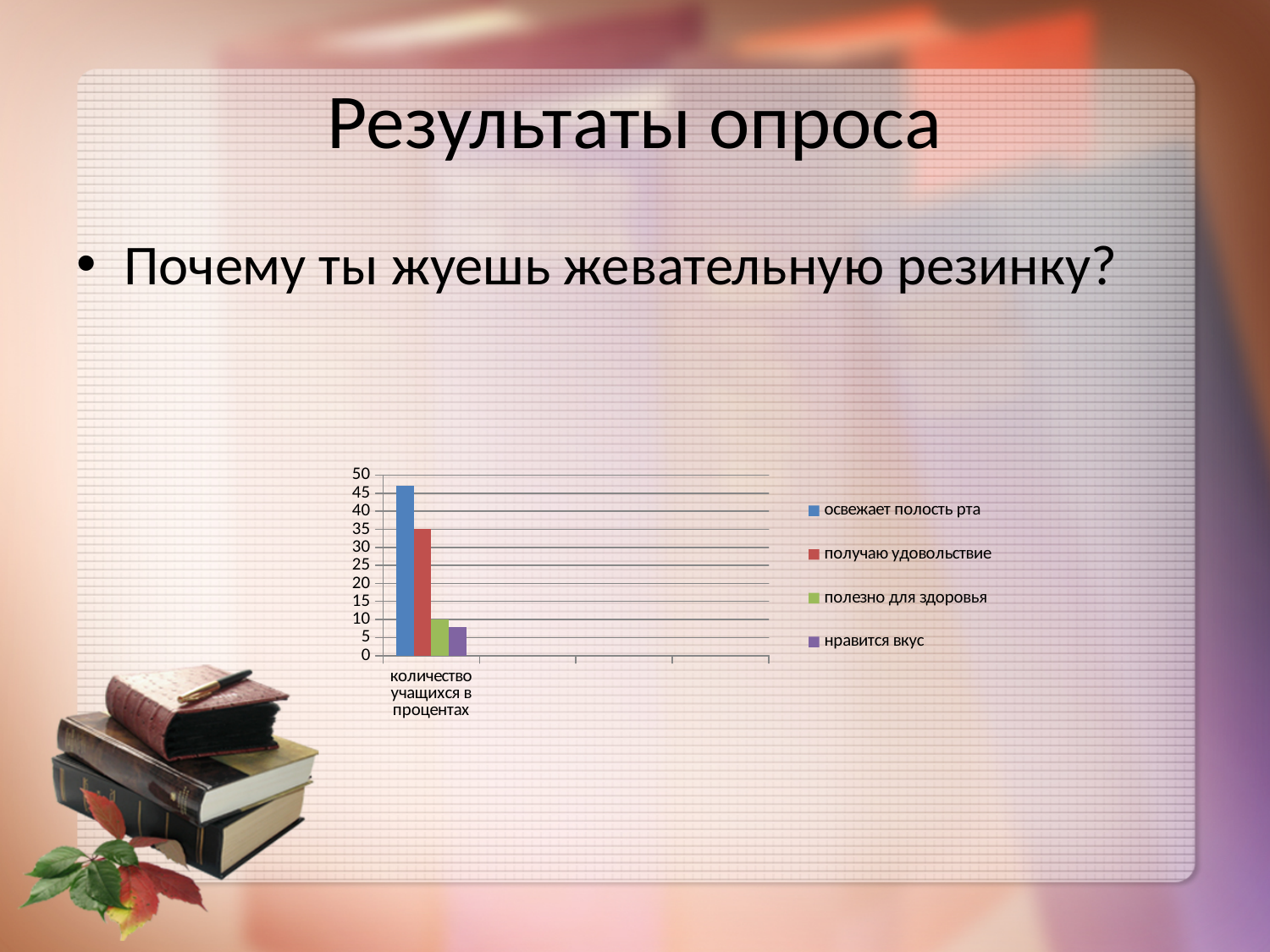
Is the value for 'нравится вкус' greater or less than 10? less Is the value for 'освежает полость рта' greater or less than 45? greater How many categories are shown on the x axis of the chart? 1 Is the value for 'полезно для здоровья' greater or less than 15? less What is the category label shown on the x axis of the chart? количество учащихся в процентах Which is larger: the value for 'освежает полость рта' or for 'получаю удовольствие'? освежает полость рта Which series has the highest value in the chart? освежает полость рта Which is larger: the value for 'полезно для здоровья' or for 'нравится вкус'? полезно для здоровья How many series does the chart legend list? 4 Which series has the lowest value in the chart? нравится вкус What kind of chart is shown on the slide? bar chart